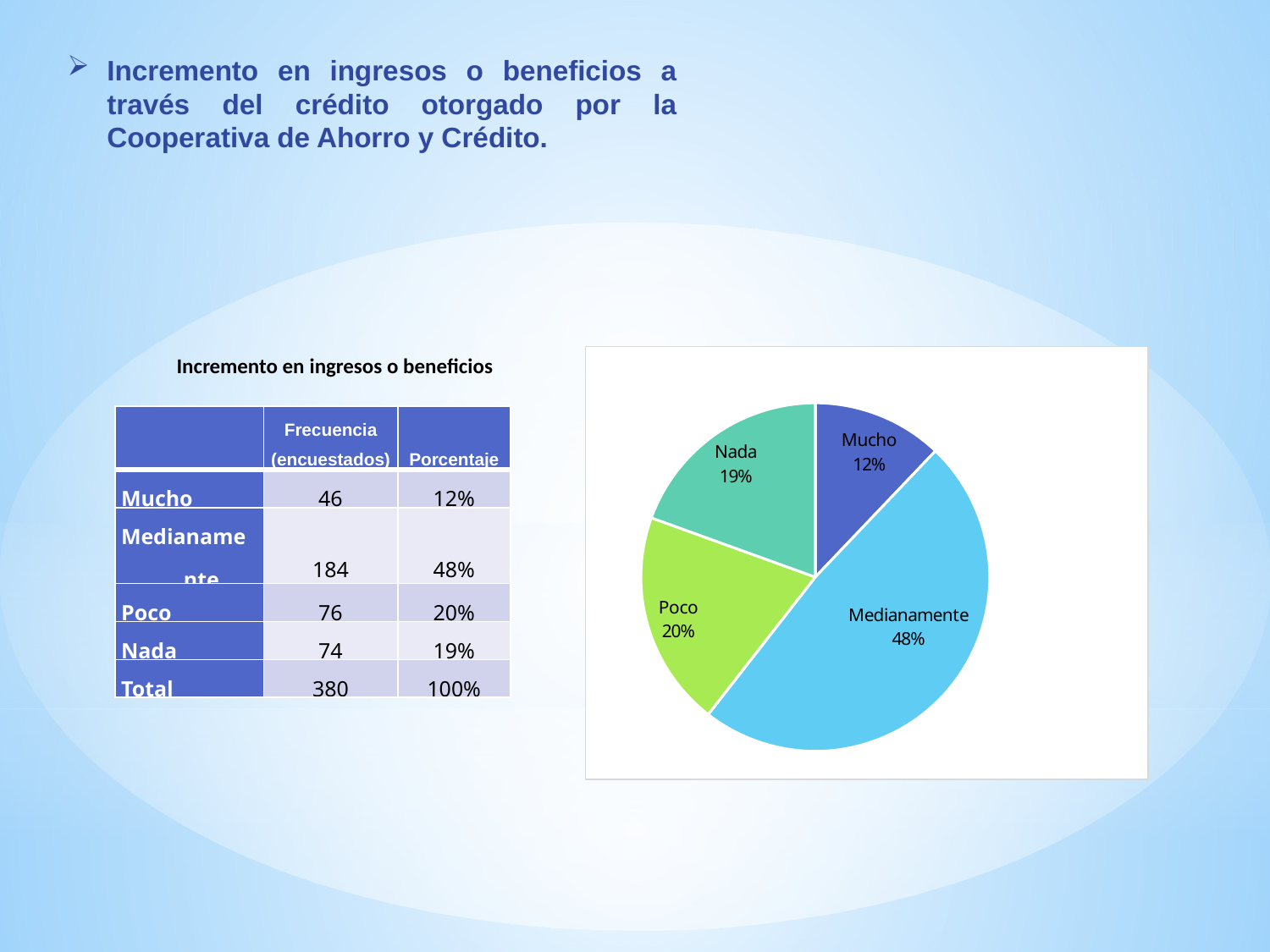
What share of the pie does the Medianamente slice represent? 48% What is the difference in percentage points between the Medianamente slice and the Mucho slice? 36 How many slices does the pie chart have? 4 Which slice is larger, Poco or Mucho? Poco What is the difference in percentage points between the Poco slice and the Nada slice? 1 What kind of chart is shown on the slide? pie chart What share of the pie does the Nada slice represent? 19% Which slice of the pie chart is the largest? Medianamente What colour is the Medianamente slice in the pie chart? light blue What share of the pie does the Mucho slice represent? 12% Which slice of the pie chart is the smallest? Mucho